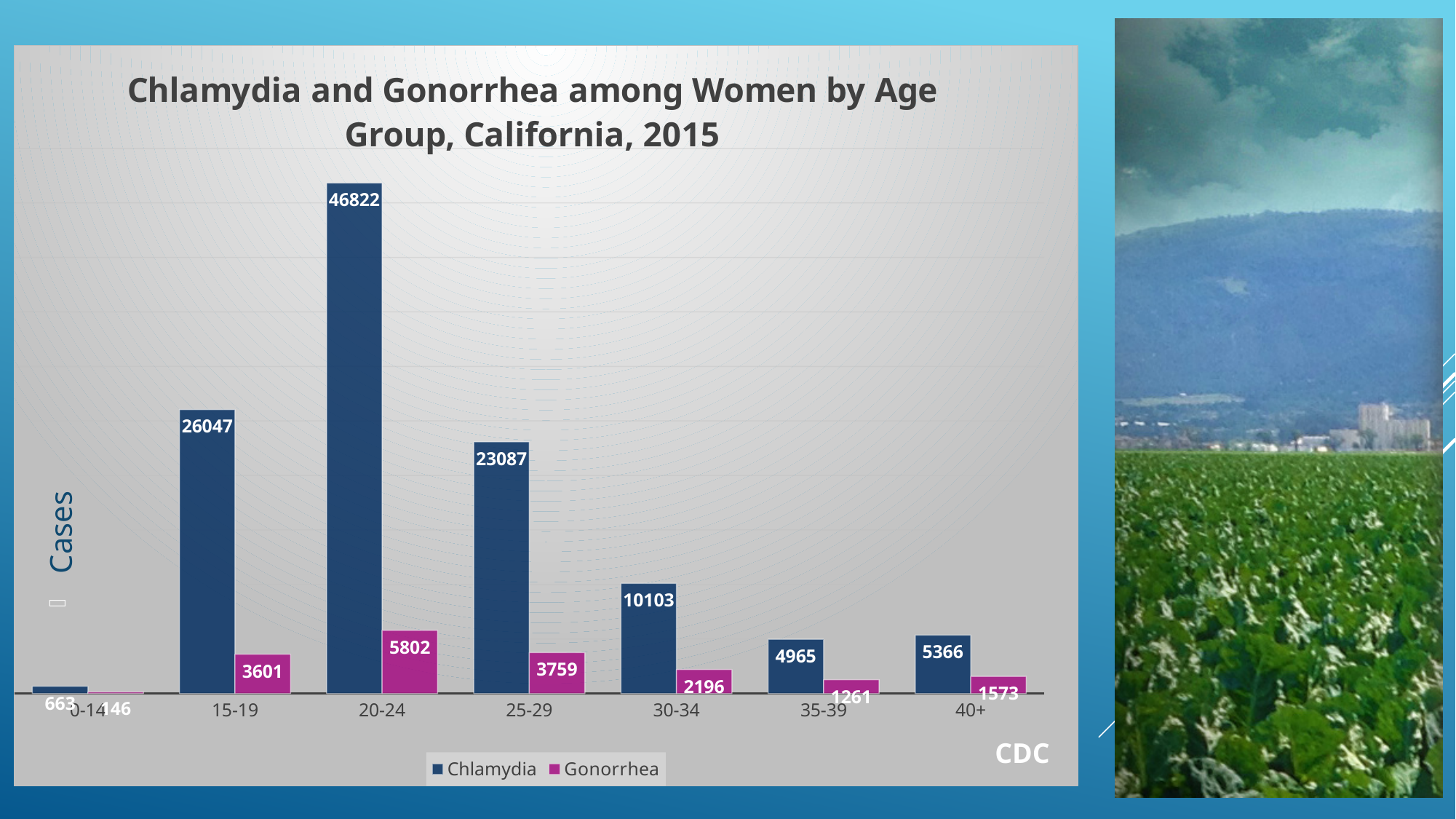
What is the Gonorrhea value for the 25-29 age group? 3759 What is the Chlamydia value for the 35-39 age group? 4965 What kind of chart is shown on the slide? bar chart Which age group has the lowest Gonorrhea value? 0-14 How many age groups are shown on the x axis? 7 Which age group has the highest Chlamydia value? 20-24 What is the title of the chart? Chlamydia and Gonorrhea among Women by Age Group, California, 2015 What is the difference between the Chlamydia values for the 15-19 and 25-29 age groups? 2960 What is the Chlamydia value for the 20-24 age group? 46822 Which is larger, the Chlamydia value for 35-39 or for 40+? 40+ What is the difference between the Gonorrhea values for the 20-24 and 30-34 age groups? 3606 How many series does the legend list? 2